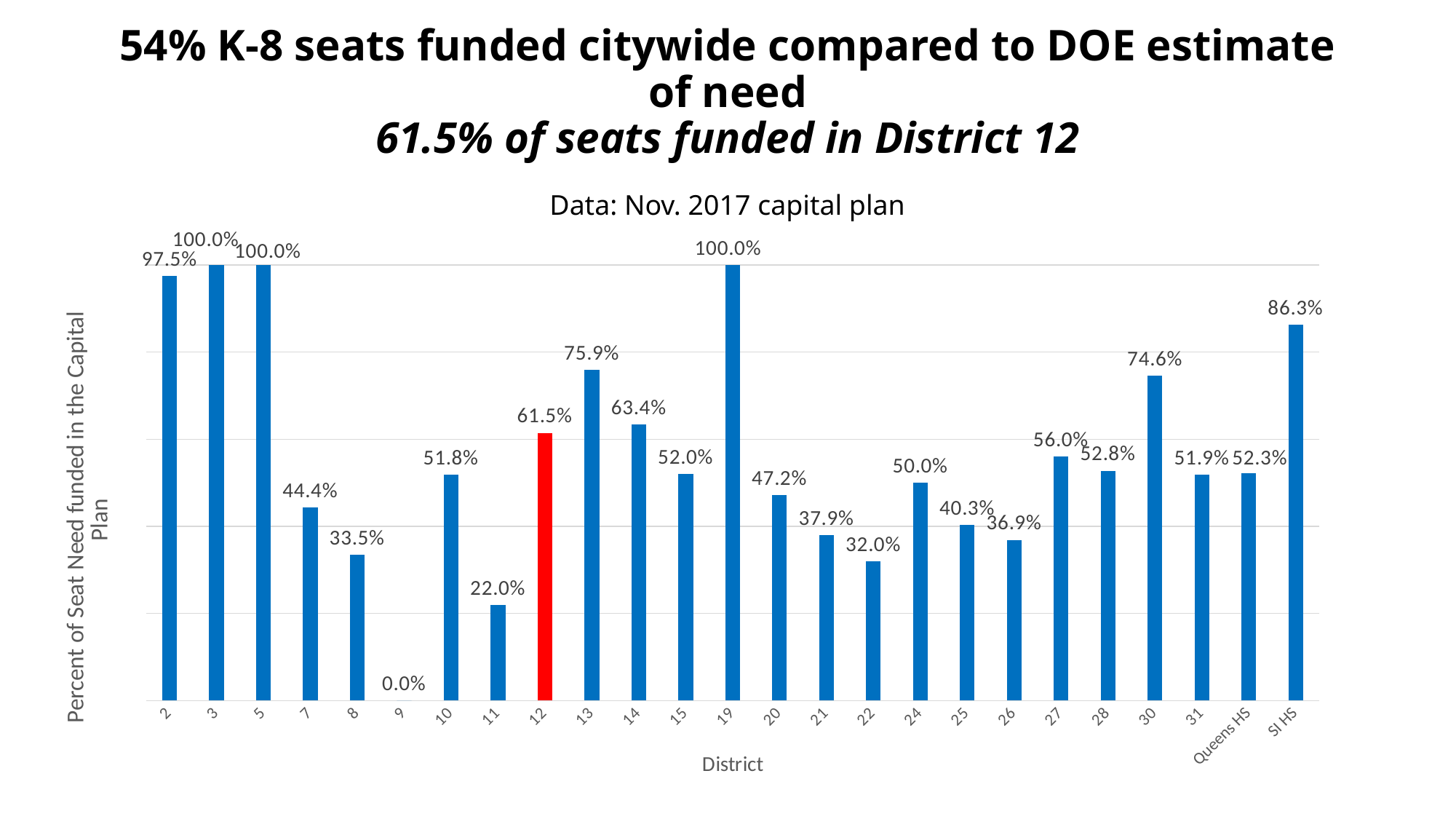
What is the percent of seat need funded for SI HS? 86.3% What is the difference between the values for SI HS and District 30? 11.7% What kind of chart is shown on the slide? Bar chart Which has a higher percent of seat need funded, District 30 or District 27? District 30 Which has a higher percent of seat need funded, District 8 or District 21? District 21 What is the difference between the values for District 13 and District 14? 12.5% What is the percent of seat need funded for District 11? 22.0% Which district has the lowest percent of seat need funded? 9 How many districts (categories) are shown on the x axis? 25 Which district's bar is coloured red? 12 What is the percent of seat need funded for District 24? 50.0% What is the percent of seat need funded for District 12? 61.5%